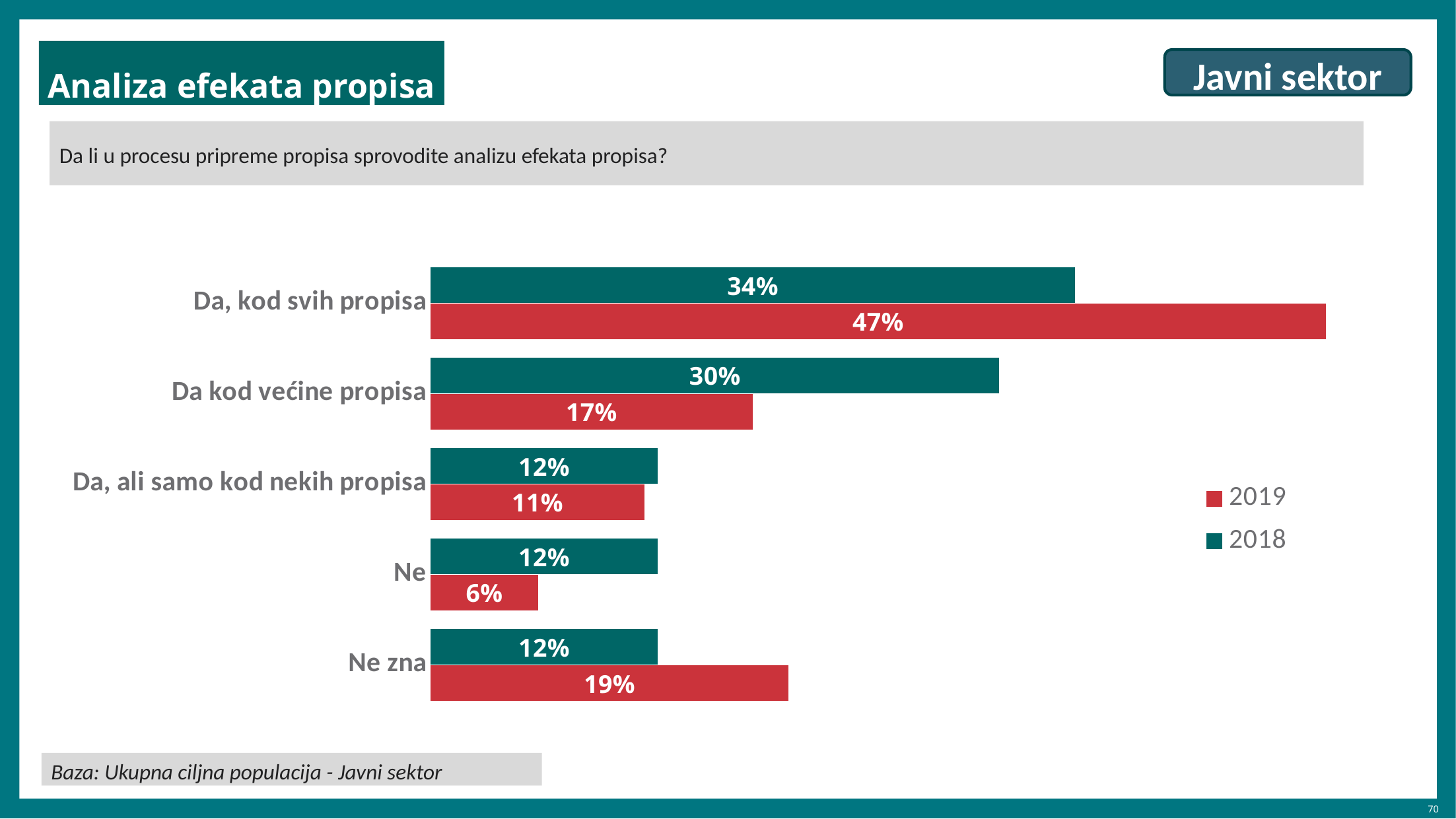
What is the difference between the 2018 and 2019 values for "Da kod većine propisa"? 13% What is the 2018 value for "Da kod većine propisa"? 30% What is the 2019 value for "Da, kod svih propisa"? 47% What is the difference between the 2019 and 2018 values for "Da, kod svih propisa"? 13% What is the 2019 value for "Ne"? 6% How many categories are shown on the chart? 5 What kind of chart is shown on the slide? Bar chart Which category has the lowest 2019 value? Ne How many series does the legend list? 2 Which is larger for "Ne zna": the 2019 value or the 2018 value? 2019 What is the 2018 value for "Ne zna"? 12% Which category has the highest 2019 value? Da, kod svih propisa